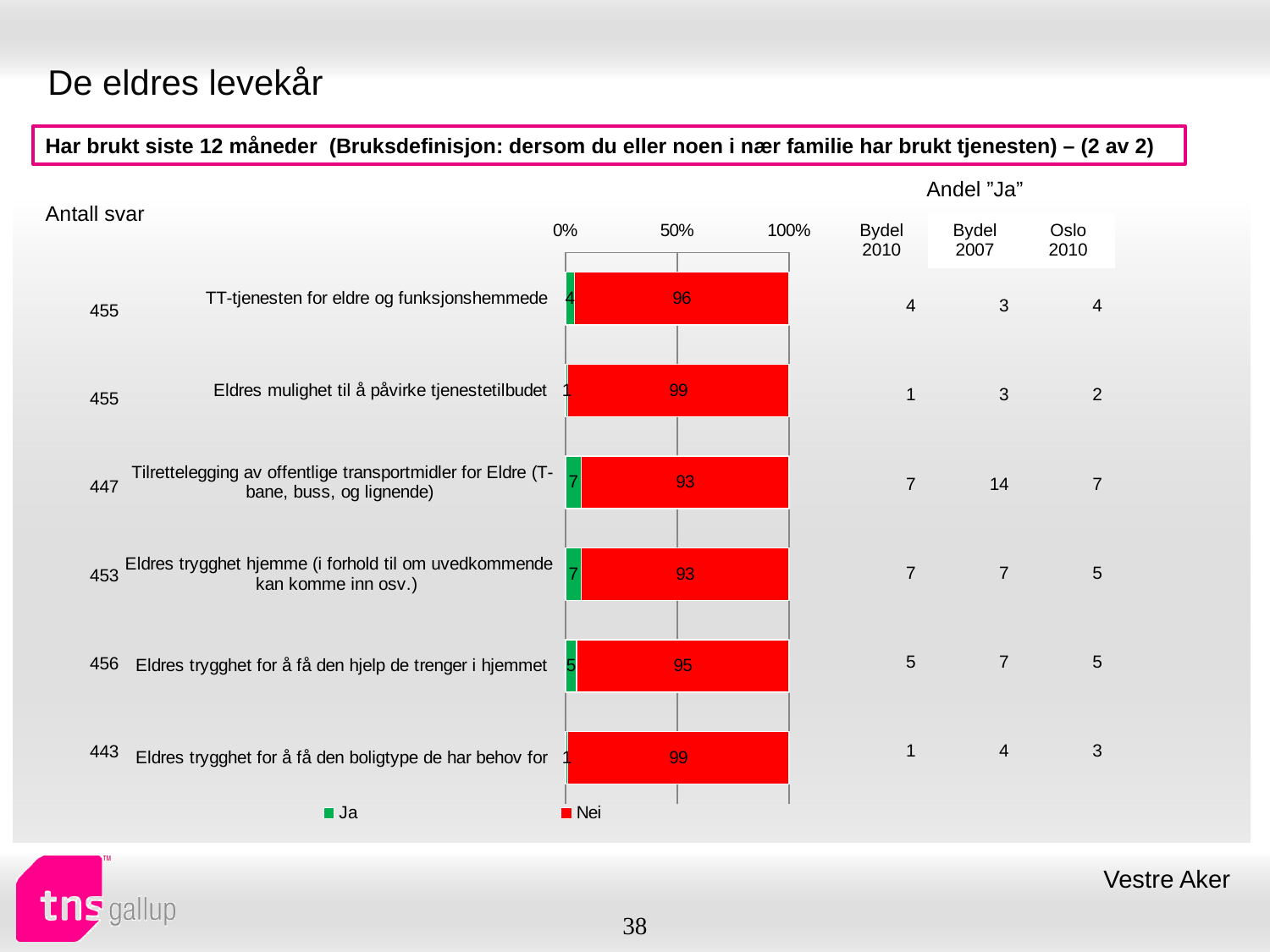
What is the Ja value for 'Tilrettelegging av offentlige transportmidler for Eldre (T-bane, buss, og lignende)'? 7 What is the difference between the Nei values for 'Eldres mulighet til å påvirke tjenestetilbudet' and 'TT-tjenesten for eldre og funksjonshemmede'? 3 What is the Nei value for 'Eldres trygghet for å få den hjelp de trenger i hjemmet'? 95 Is the Nei value for 'Eldres trygghet hjemme (i forhold til om uvedkommende kan komme inn osv.)' greater or less than 50%? greater Which is larger: the Ja value for 'Eldres trygghet for å få den hjelp de trenger i hjemmet' or the Ja value for 'Eldres trygghet for å få den boligtype de har behov for'? Eldres trygghet for å få den hjelp de trenger i hjemmet What is the Nei value for 'Eldres mulighet til å påvirke tjenestetilbudet'? 99 Which category has the lowest Nei value? Tilrettelegging av offentlige transportmidler for Eldre (T-bane, buss, og lignende) and Eldres trygghet hjemme (i forhold til om uvedkommende kan komme inn osv.) How many series does the chart legend list? 2 What is the Nei value for 'TT-tjenesten for eldre og funksjonshemmede'? 96 How many categories are plotted in the chart? 6 What kind of chart is shown on the slide? bar chart What are the two series named in the chart legend? Ja and Nei